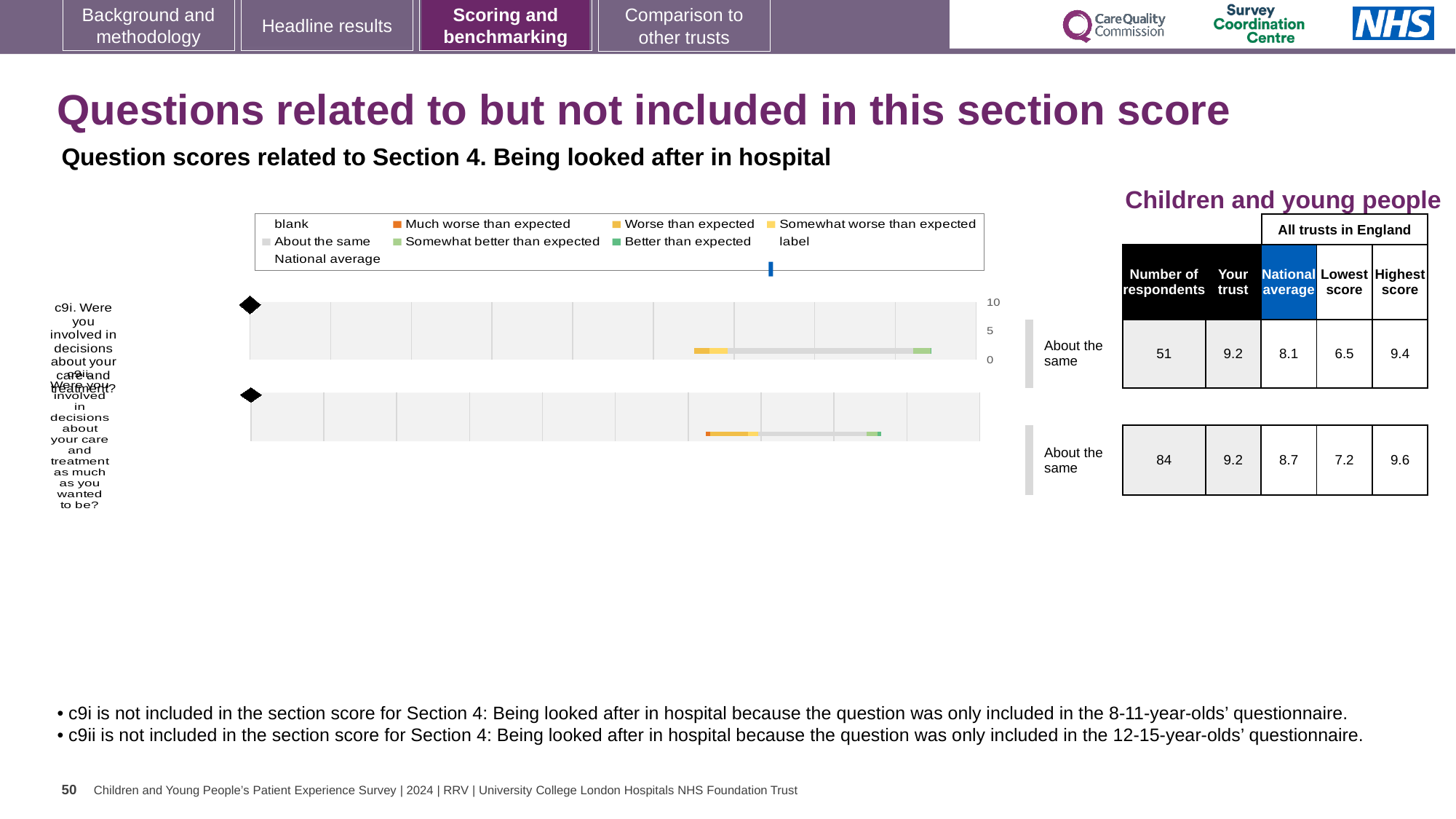
In the table, what is the number of respondents for question c9ii? 84 In the table, what is the lowest score across all trusts in England for question c9i? 6.5 Which question has the higher national average, c9i or c9ii? c9ii What is the highest value shown on the vertical axis of the c9i chart? 10 How many question charts are shown on the slide? 2 In the table, what is the highest score across all trusts in England for question c9ii? 9.6 In the table, what is the 'Your trust' score for question c9i? 9.2 What is the difference between the 'Your trust' score and the national average for question c9i? 1.1 What kind of chart is used to show the benchmarking results for questions c9i and c9ii? bar chart Which legend entry is shown with a dark orange colour? Much worse than expected In the table, what is the national average for question c9ii? 8.7 In the table, what is the number of respondents for question c9i? 51